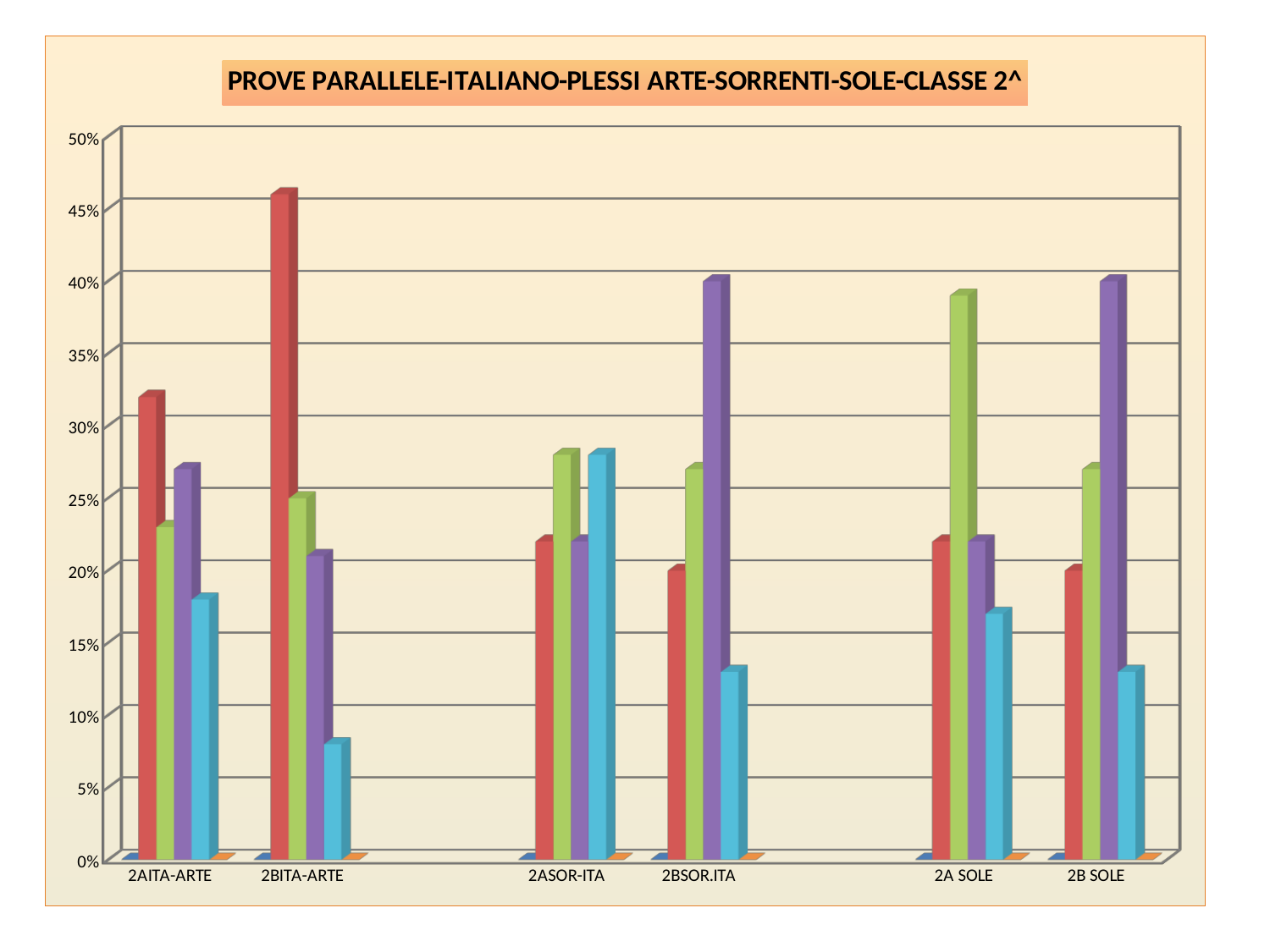
What kind of chart is shown on the slide? bar chart Which category has the tallest green bar? 2A SOLE Is the value of the light blue bar for 2BSOR.ITA greater or less than 15%? less Is the value of the red bar for 2BITA-ARTE greater or less than 40%? greater Is the value of the light blue bar for 2BITA-ARTE greater or less than 10%? less Which category has the tallest red bar? 2BITA-ARTE Which category has the shortest light blue bar? 2BITA-ARTE How many categories are shown on the x axis of the chart? 6 What is the title of the chart? PROVE PARALLELE-ITALIANO-PLESSI ARTE-SORRENTI-SOLE-CLASSE 2^ Which is larger, the green bar for 2A SOLE or the green bar for 2B SOLE? 2A SOLE Which is larger, the red bar for 2AITA-ARTE or the red bar for 2BITA-ARTE? 2BITA-ARTE